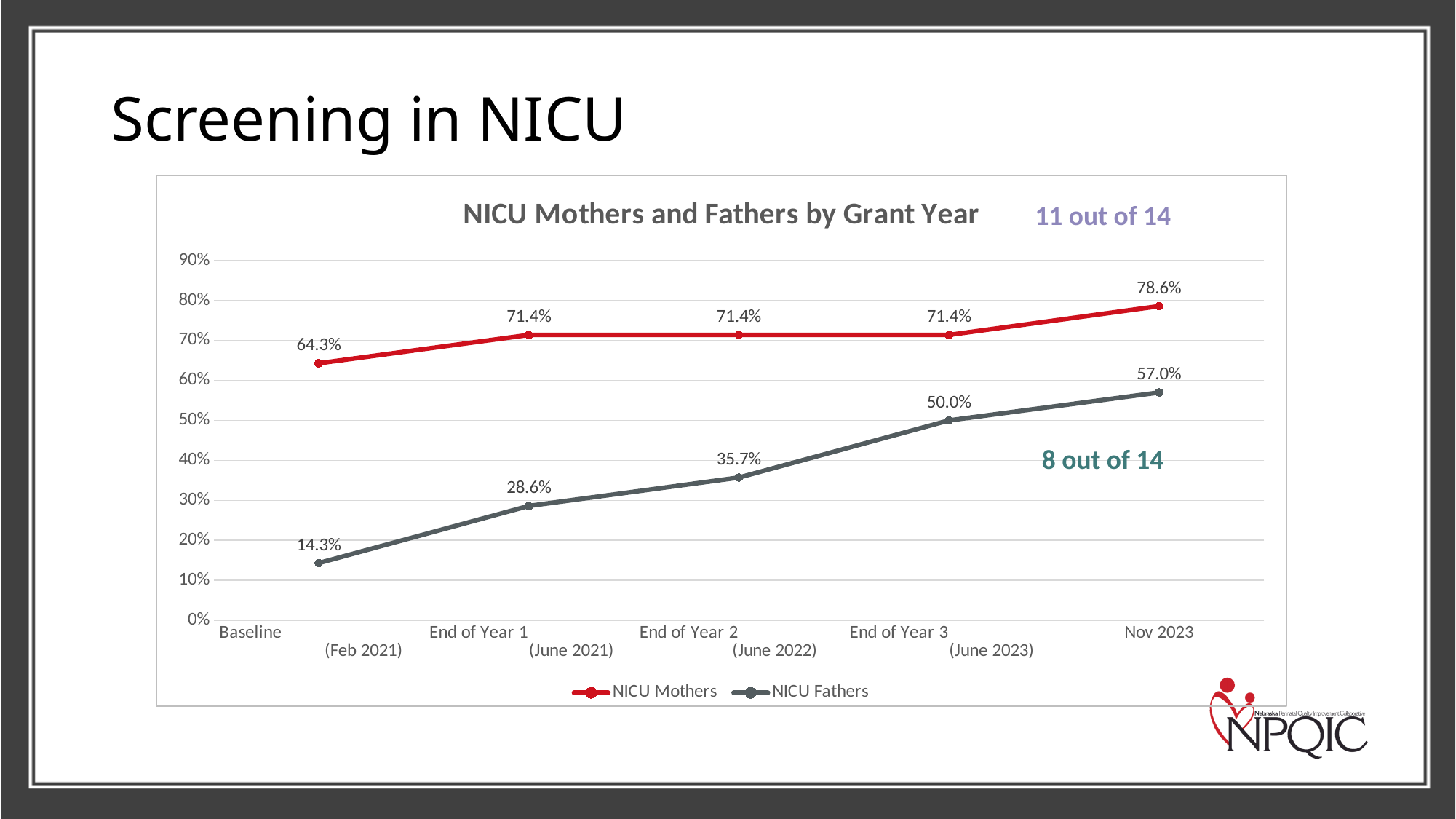
What is the value for NICU Mothers at End of Year 3 (June 2023)? 71.4% At which time point is the NICU Mothers value highest? Nov 2023 At which time point is the NICU Fathers value lowest? Baseline (Feb 2021) How many series does the legend list? 2 What is the value for NICU Fathers at End of Year 2 (June 2022)? 35.7% What is the difference between the NICU Fathers values at End of Year 3 (June 2023) and End of Year 2 (June 2022)? 14.3% How many time points are plotted on the x axis? 5 What is the difference between NICU Mothers and NICU Fathers at Nov 2023? 21.6% What is the value for NICU Mothers at Baseline (Feb 2021)? 64.3% Which series has the higher value at End of Year 1 (June 2021), NICU Mothers or NICU Fathers? NICU Mothers What kind of chart is shown on the slide? Line chart What is the value for NICU Fathers at Nov 2023? 57.0%